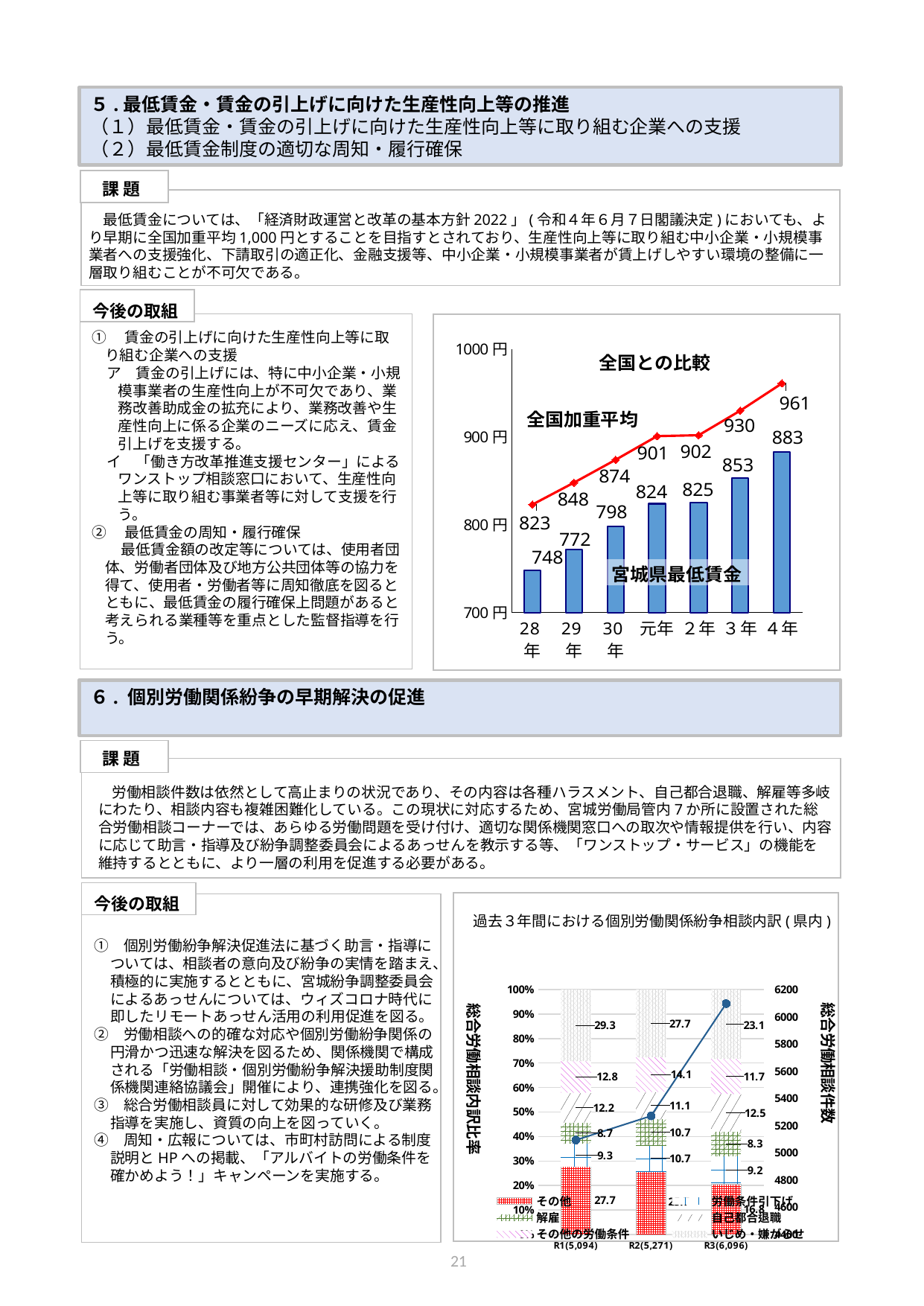
In the chart titled 全国との比較, which year has the highest 宮城県最低賃金 bar? 4年 In the chart titled 全国との比較, which year has the lowest 宮城県最低賃金 bar? 28年 In the chart titled 過去3年間における個別労働関係紛争相談内訳(県内), how many categories are shown on the x axis? 3 In the chart titled 全国との比較, do the 宮城県最低賃金 bars rise or fall from 28年 to 4年? rise In the chart titled 全国との比較, what is the 宮城県最低賃金 value for 4年? 883 In the chart titled 全国との比較, what is the 全国加重平均 value for 28年? 823 In the chart titled 過去3年間における個別労働関係紛争相談内訳(県内), does the 総合労働相談件数 line rise or fall from R1 to R3? rise In the chart titled 全国との比較, which is larger for 30年: the 全国加重平均 or the 宮城県最低賃金? 全国加重平均 In the chart titled 全国との比較, how many years are shown on the x axis? 7 In the chart titled 全国との比較, what is the difference between the 全国加重平均 and the 宮城県最低賃金 for 4年? 78 In the chart titled 全国との比較, what is the 宮城県最低賃金 value for 元年? 824 In the chart titled 全国との比較, what is the 全国加重平均 value for 3年? 930